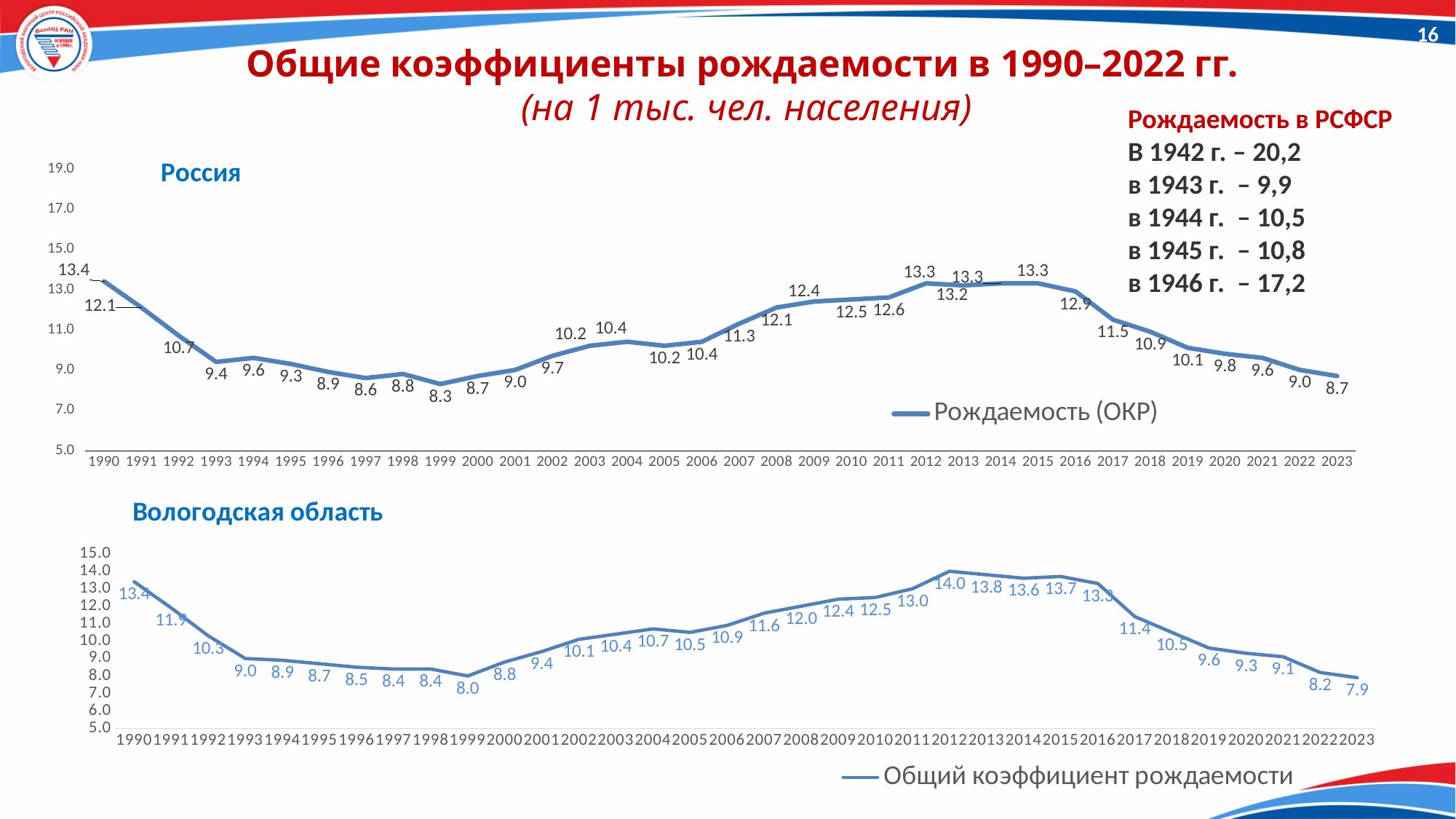
In the 'Вологодская область' chart, what is the value for 2012? 14.0 In the 'Россия' chart, which year has the lowest value? 1999 In the 'Вологодская область' chart, is the value for 2017 larger than the value for 2018? Yes How many years are plotted in the 'Россия' chart? 34 In the 'Россия' chart, what is the value for 1999? 8.3 In the 'Россия' chart, what is the difference between the values for 1990 and 1991? 1.3 What is the legend entry of the 'Вологодская область' chart? Общий коэффициент рождаемости In the 'Вологодская область' chart, which year has the highest value? 2012 In the 'Вологодская область' chart, which year has the lowest value? 2023 In the 'Россия' chart, what is the value for 2023? 8.7 What type of chart is the 'Россия' chart? line chart In the 'Вологодская область' chart, what is the difference between the values for 2012 and 2023? 6.1